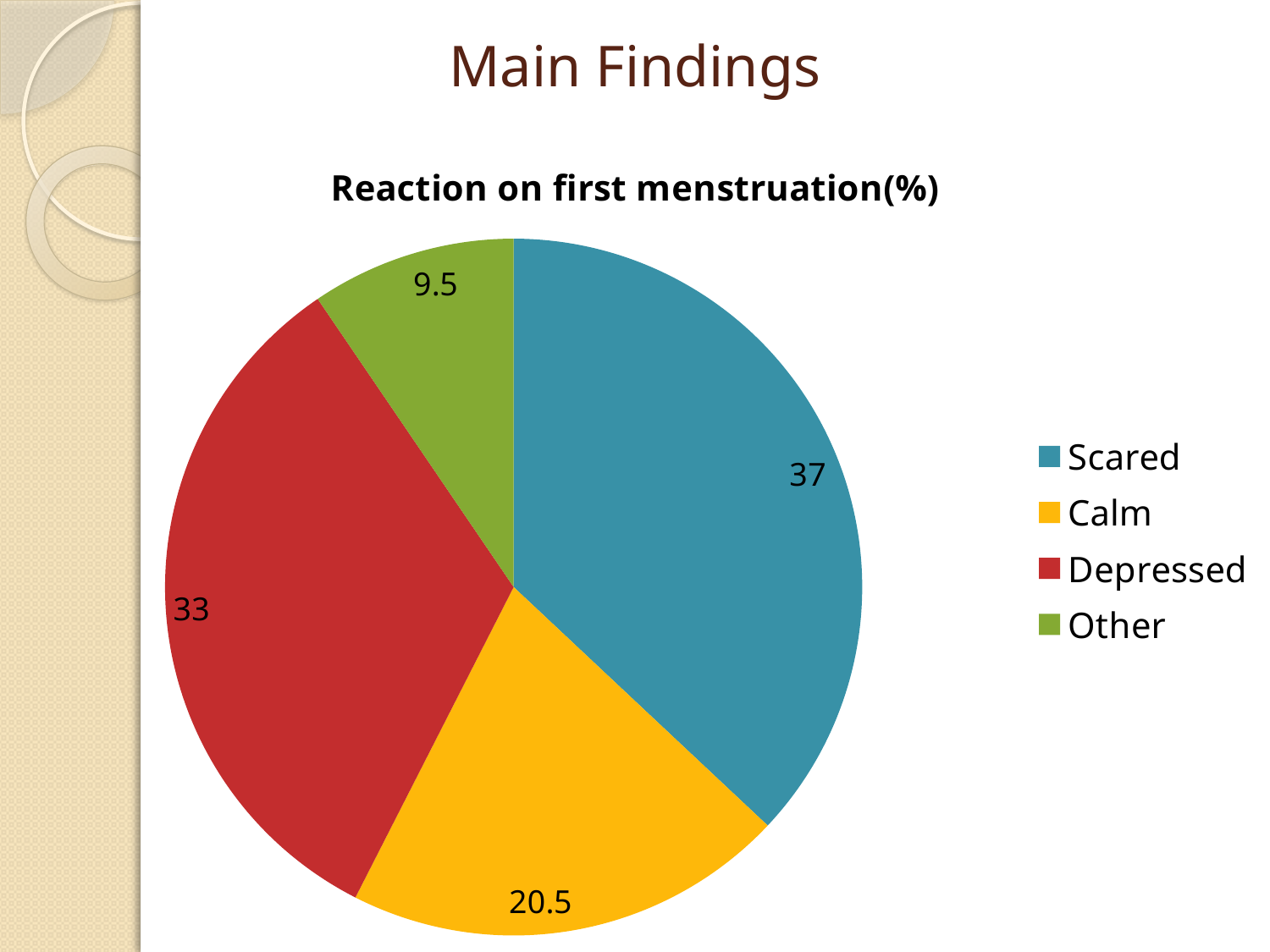
What is the value for Calm in the pie chart? 20.5 Which reaction has the largest slice of the pie chart? Scared What kind of chart is shown on the slide? Pie chart What is the value for Scared in the pie chart? 37 What is the value for Other in the pie chart? 9.5 What is the difference between the values for Scared and Depressed? 4 How many slices does the pie chart have? 4 What is the difference between the values for Calm and Other? 11 Which reaction has the smallest slice of the pie chart? Other What is the title of the chart? Reaction on first menstruation(%) Which is larger, the value for Depressed or the value for Calm? Depressed What is the value for Depressed in the pie chart? 33